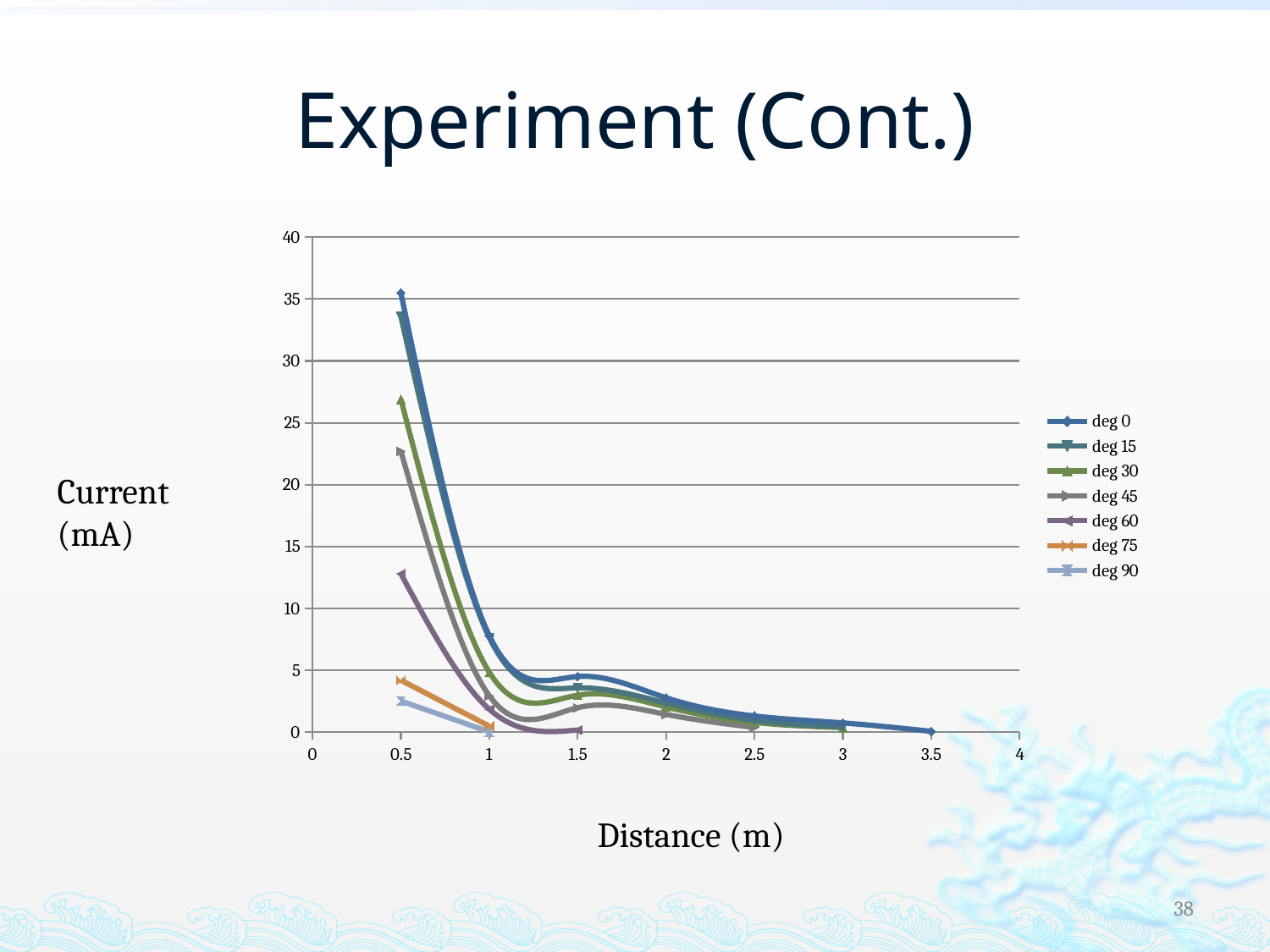
Is the current for deg 0 at 0.5 m greater or less than 30 mA? greater Which series has the highest current at a distance of 0.5 m? deg 0 Does the current for deg 0 generally rise or fall as distance increases? fall What kind of chart is shown on the slide? line chart Is the current for deg 60 at 0.5 m greater or less than 15 mA? less How many series does the legend list? 7 At a distance of 0.5 m, which series has the larger current, deg 30 or deg 45? deg 30 Which series extends to the largest distance on the x axis? deg 0 Which series has the lowest current at a distance of 0.5 m? deg 90 Is the current for deg 75 at 0.5 m greater or less than 5 mA? less What is the label of the x axis? Distance (m)